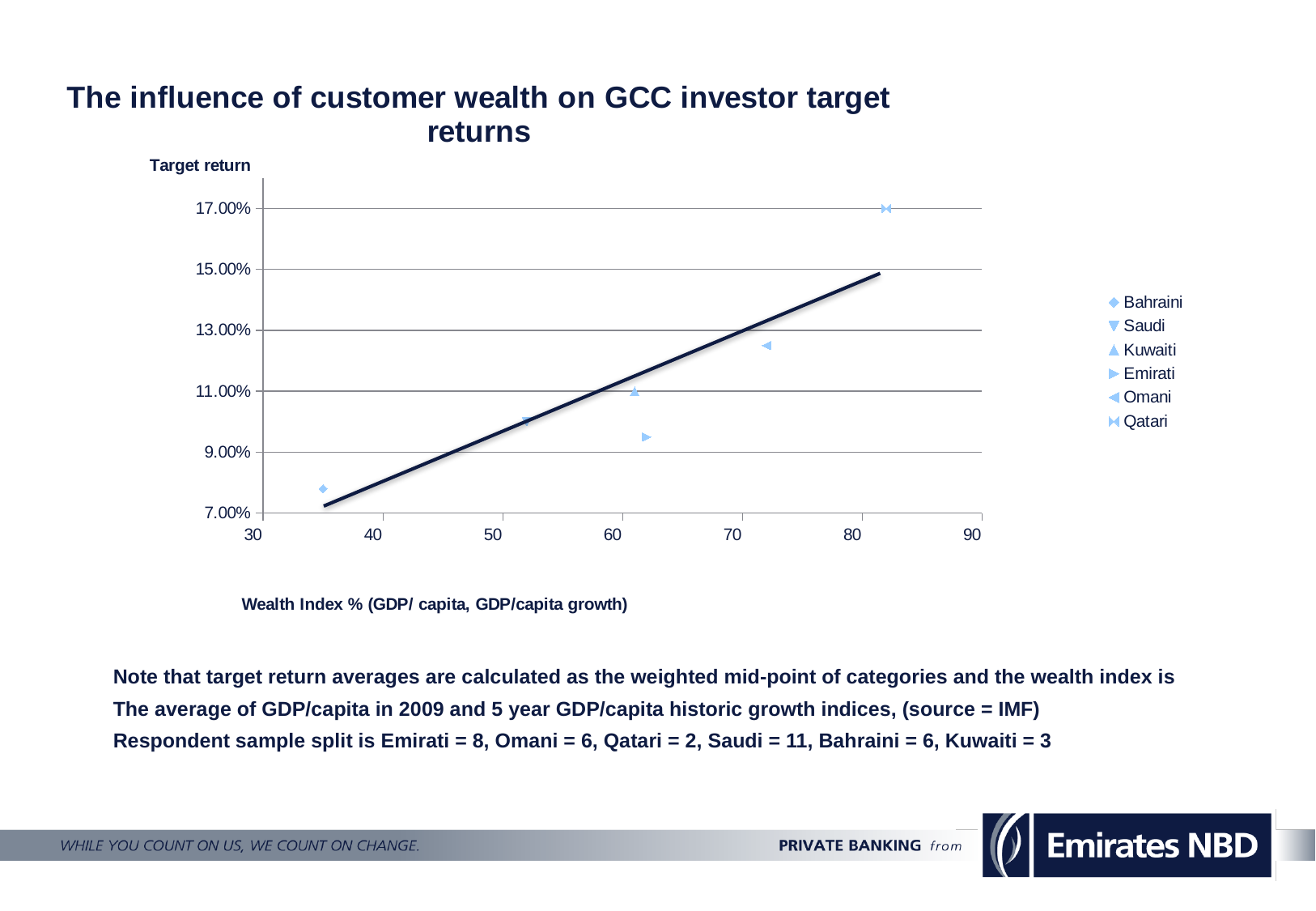
What is the label of the vertical axis? Target return Is the target return for Omani greater or less than 11.00%? greater Is the target return for Bahraini greater or less than 9.00%? less Which nationality has the highest target return? Qatari Does the trend line rise or fall as the wealth index increases? Rises Which nationality has the lowest target return? Bahraini How many series does the legend list? 6 What kind of chart is shown on the slide? Scatter chart Which has the higher target return, Saudi or Emirati? Saudi Which has the higher target return, Omani or Kuwaiti? Omani Is the wealth index for Qatari greater or less than 80? greater